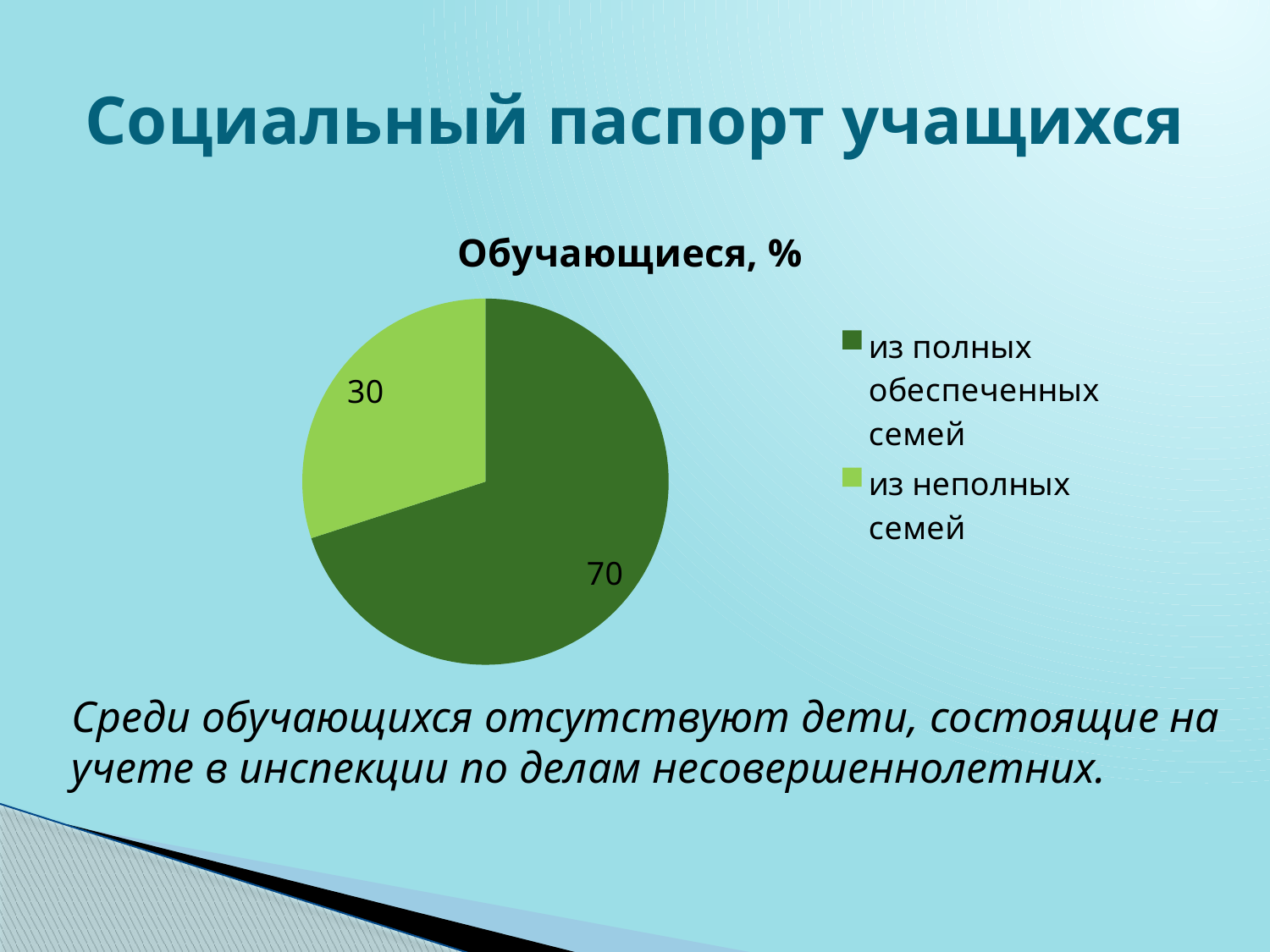
What is the value for 'из неполных семей'? 30 What type of chart is shown on the slide? pie chart What share of the pie does 'из неполных семей' represent? 30% How many entries does the legend list? 2 What is the difference between the values for 'из полных обеспеченных семей' and 'из неполных семей'? 40 Which is larger: the value for 'из полных обеспеченных семей' or 'из неполных семей'? из полных обеспеченных семей What is the value for 'из полных обеспеченных семей'? 70 How many slices does the pie chart have? 2 Which category has the smallest slice of the pie? из неполных семей Which category has the largest slice of the pie? из полных обеспеченных семей What is the title of the chart? Обучающиеся, % What colour is the slice for 'из неполных семей'? light green